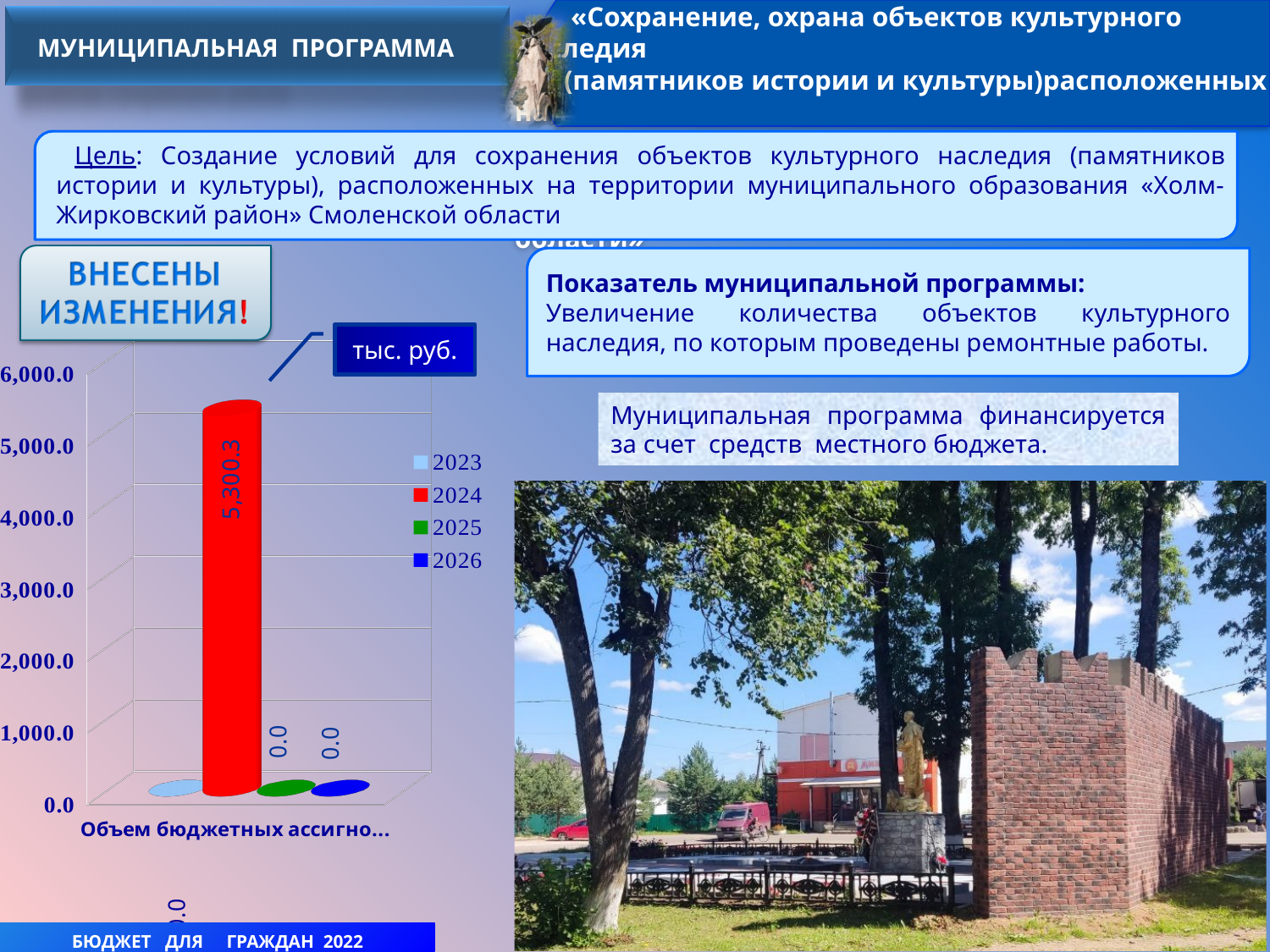
What is the value for 2025 in the bar chart? 0.0 What is the difference between the values for 2024 and 2026 in the bar chart? 5,300.3 What colour represents 2024 in the legend of the bar chart? red Which year has the highest value in the bar chart? 2024 What is the value for 2024 in the bar chart? 5,300.3 Is the value for 2024 greater or less than 6,000.0? less How many series does the legend of the bar chart list? 4 What kind of chart is shown on the slide? bar chart Which is larger in the bar chart, the value for 2024 or the value for 2025? 2024 What unit is indicated in the box above the bar chart? тыс. руб. What is the value for 2026 in the bar chart? 0.0 Is the value for 2024 greater or less than 5,000.0? greater